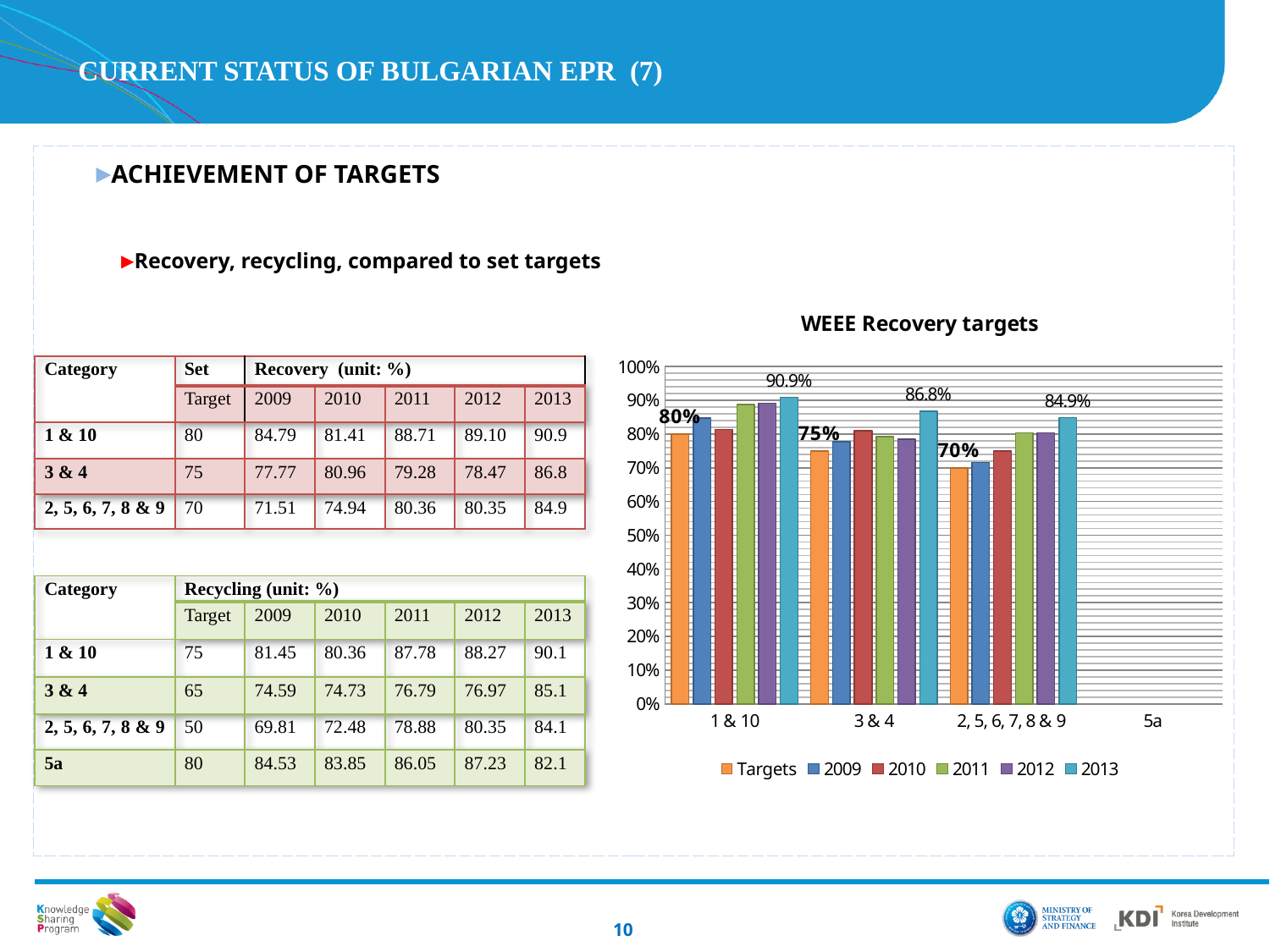
In the WEEE Recovery targets chart, is the 2013 value for category 1 & 10 larger than the 2013 value for category 2, 5, 6, 7, 8 & 9? Yes How many categories are shown on the x axis of the WEEE Recovery targets chart? 4 What is the title of the chart on the slide? WEEE Recovery targets In the WEEE Recovery targets chart, is the 2009 value for category 2, 5, 6, 7, 8 & 9 greater or less than 80%? less What type of chart is the WEEE Recovery targets chart? bar chart In the WEEE Recovery targets chart, what is the 2013 value for category 2, 5, 6, 7, 8 & 9? 84.9% In the WEEE Recovery targets chart, which category has the lowest Targets value? 2, 5, 6, 7, 8 & 9 How many series does the legend of the WEEE Recovery targets chart list? 6 In the WEEE Recovery targets chart, what is the difference between the 2013 value and the Targets value for category 3 & 4? 11.8% In the WEEE Recovery targets chart, what is the Targets value for category 3 & 4? 75% In the WEEE Recovery targets chart, what is the 2013 value for category 1 & 10? 90.9% In the WEEE Recovery targets chart, what is the Targets value for category 1 & 10? 80%